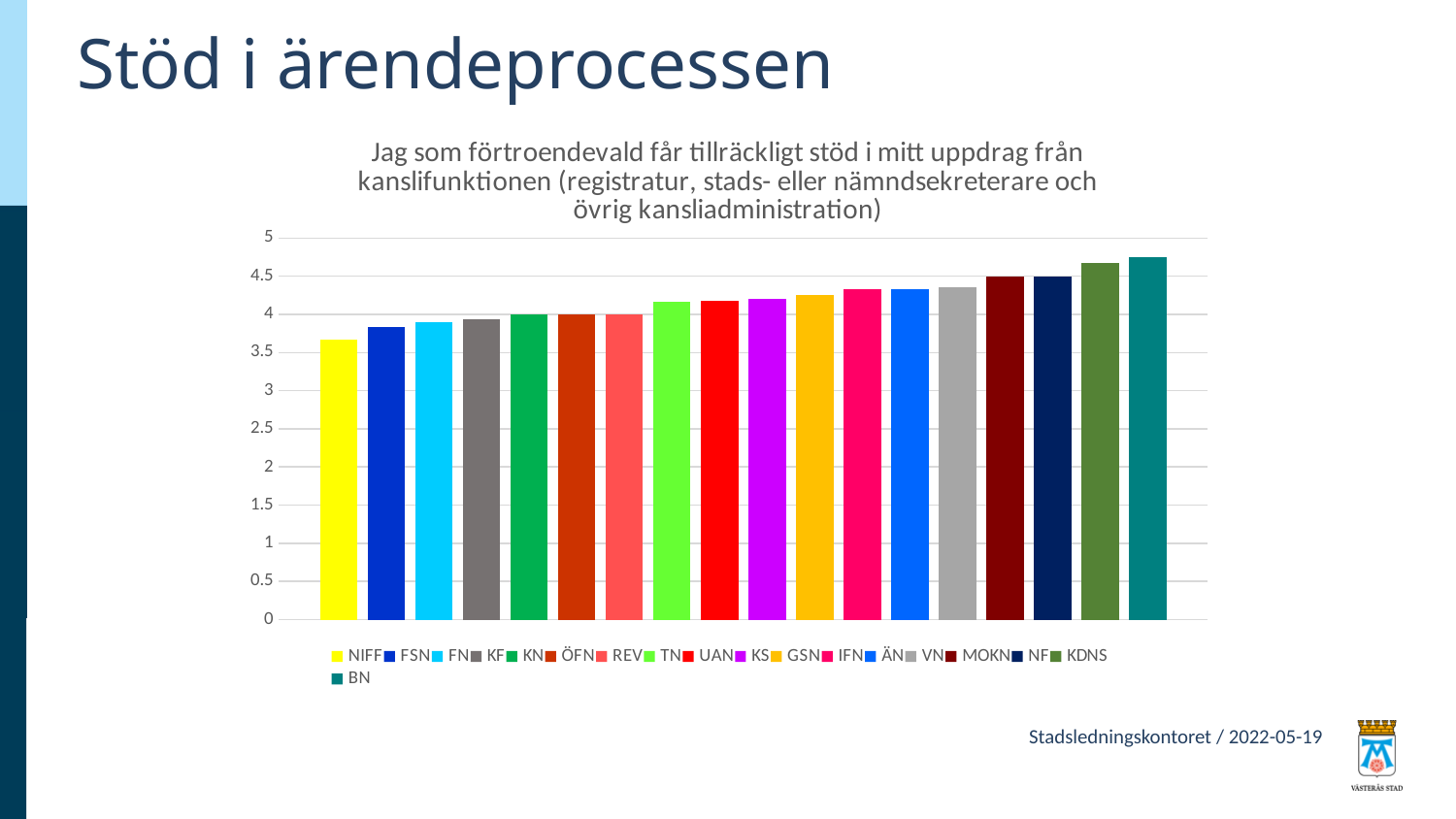
How many entries does the legend list? 18 Is the value for FSN greater or less than 4? less How many bars are plotted in the chart? 18 What kind of chart is shown on the slide? bar chart Which category has the highest value in the chart? BN Is the value for BN greater or less than 4.5? greater Is the value for NIFF greater or less than 4? less What colour is the bar for NIFF? yellow Which category has the lowest value in the chart? NIFF Which has the larger value, KDNS or FSN? KDNS Do the bar values rise or fall from left to right along the x axis? rise